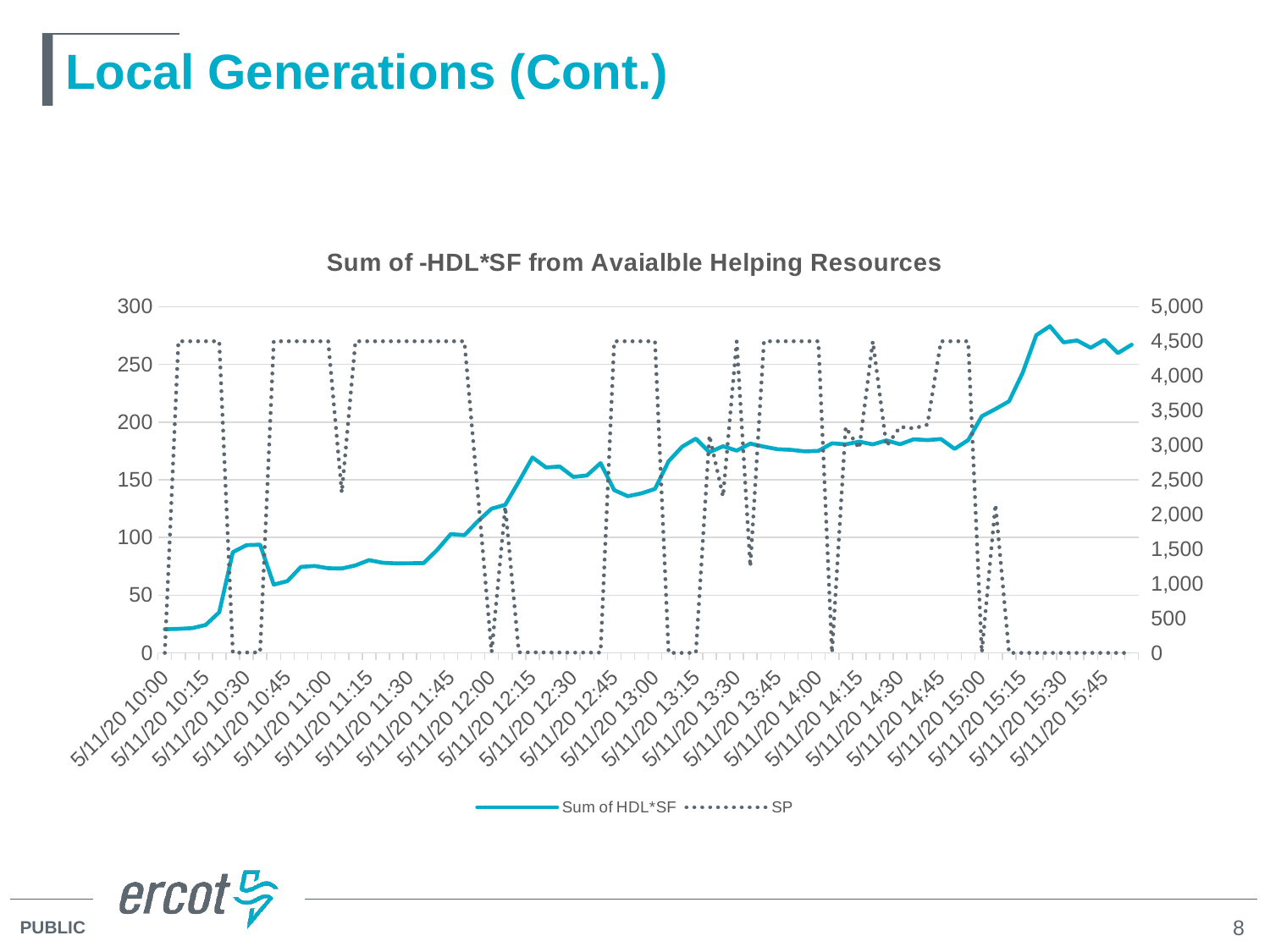
What is the title of the chart? Sum of -HDL*SF from Avaialble Helping Resources Is the value of SP at 5/11/20 15:45 greater or less than 500? less Which series is drawn with a dotted line? SP Does the Sum of HDL*SF series generally rise or fall from 10:00 to 15:45? rise Is the value of Sum of HDL*SF at 5/11/20 11:00 greater or less than 100? less What is the highest value shown on the right-hand vertical axis? 5,000 What kind of chart is shown on the slide? line chart Is the value of Sum of HDL*SF at 5/11/20 15:30 greater or less than 250? greater How many series does the legend list? 2 Is the value of Sum of HDL*SF higher at 5/11/20 15:30 or at 5/11/20 10:30? 5/11/20 15:30